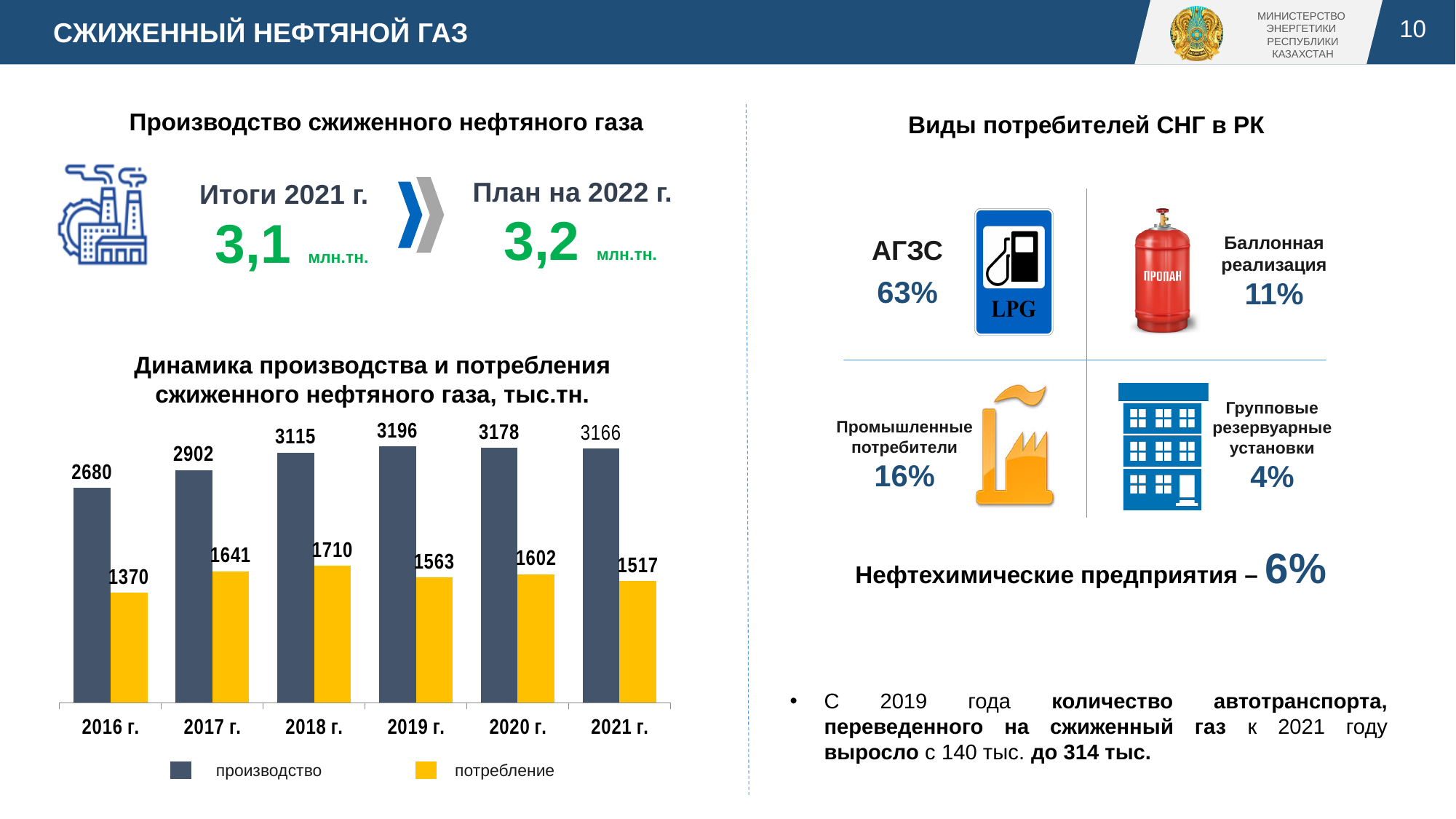
In which year was потребление the lowest? 2016 г. What was the value of производство in 2021 г.? 3166 How many years are shown on the x axis of the chart? 6 What is the difference between производство and потребление in 2020 г.? 1576 What was the value of производство in 2016 г.? 2680 What was the value of потребление in 2018 г.? 1710 How many series does the chart legend list? 2 In which year was производство the highest? 2019 г. What colour are the потребление bars in the chart? yellow Did производство rise or fall from 2016 г. to 2019 г.? rise Which is larger: потребление in 2017 г. or потребление in 2019 г.? 2017 г. What type of chart is shown on the slide? bar chart